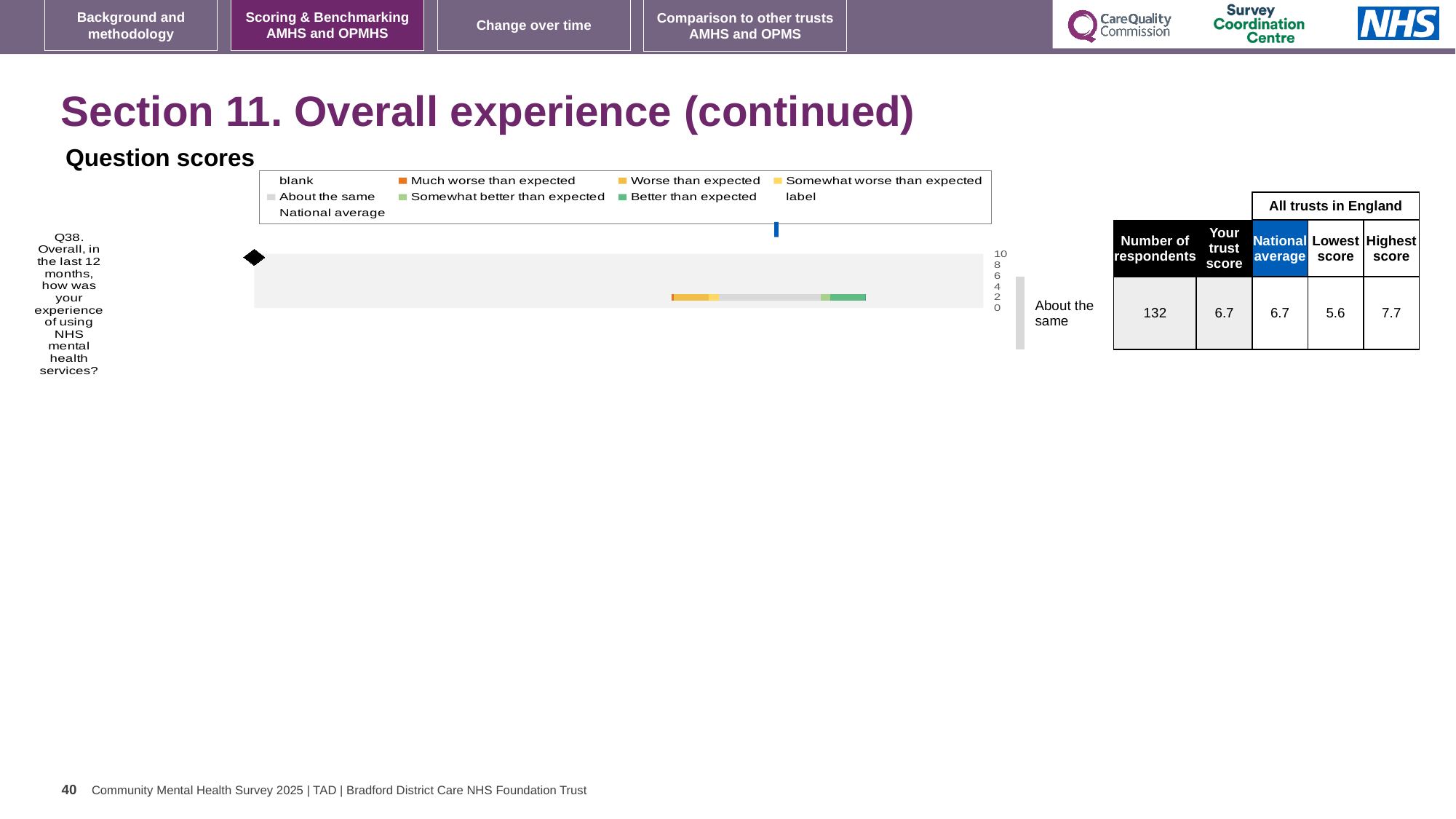
In the table beside the chart, what is the lowest score among all trusts in England for Q38? 5.6 Which question number is plotted in the Question scores chart? Q38 In the table beside the chart, what is the trust's score for Q38? 6.7 What kind of chart is used to show the Q38 question score? bar chart In the table beside the chart, what is the number of respondents for Q38? 132 In the table beside the chart, what is the national average for Q38? 6.7 What is the difference between the highest score and the lowest score for Q38? 2.1 How many questions are plotted in the Question scores chart? 1 What benchmark category is the trust's Q38 result labelled as next to the chart? About the same In the table beside the chart, what is the highest score among all trusts in England for Q38? 7.7 Is the trust's score for Q38 higher than, lower than, or the same as the national average? the same What colour does the legend use for 'Much worse than expected'? orange